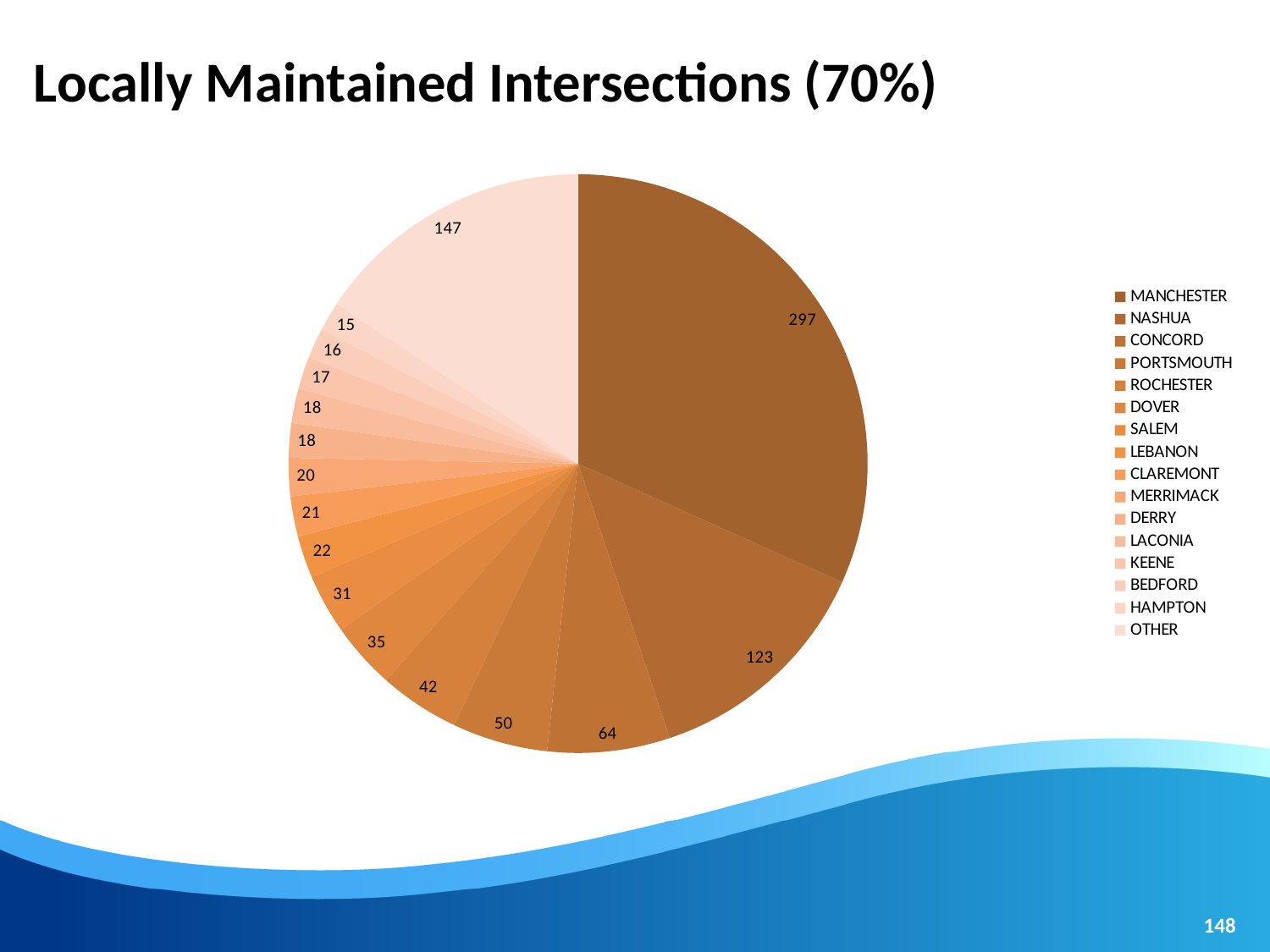
Which is larger, the Other slice or the Nashua slice? Other What is the value for Nashua? 123 Which category has the smallest slice? Hampton What is the difference between the values for Portsmouth and Rochester? 8 What is the value for Concord? 64 What is the title of the slide? Locally Maintained Intersections (70%) What is the value for the Other slice? 147 Which category has the largest slice? Manchester What is the value for Manchester? 297 What is the difference between the values for Manchester and Nashua? 174 How many categories does the legend list? 16 What type of chart is shown on the slide? pie chart